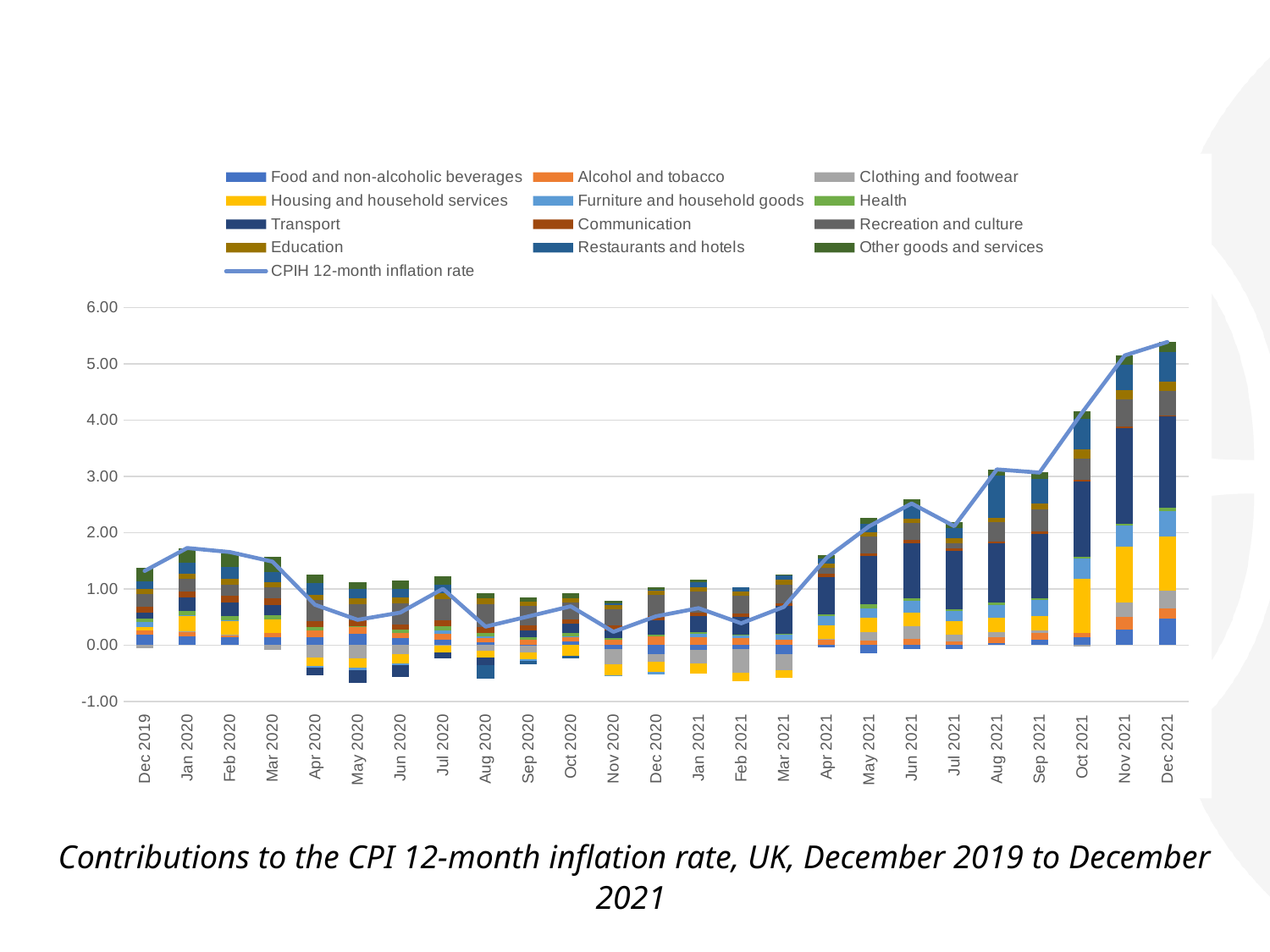
Which month has the highest CPIH 12-month inflation rate? Dec 2021 Does the CPIH 12-month inflation rate rise or fall from Mar 2021 to Dec 2021? Rise Which is larger, the CPIH 12-month inflation rate in Dec 2019 or in Dec 2021? Dec 2021 Is the CPIH 12-month inflation rate for Dec 2021 greater or less than 5.00? greater What is the title of the chart? Contributions to the CPI 12-month inflation rate, UK, December 2019 to December 2021 Which legend entry is plotted as a line rather than as bars? CPIH 12-month inflation rate Is the CPIH 12-month inflation rate for May 2020 greater or less than 1.00? less How many entries does the legend list? 13 What kind of chart is shown on the slide? Stacked bar chart with a line How many months are shown along the x axis? 25 Is the CPIH 12-month inflation rate for Nov 2020 greater or less than 1.00? less